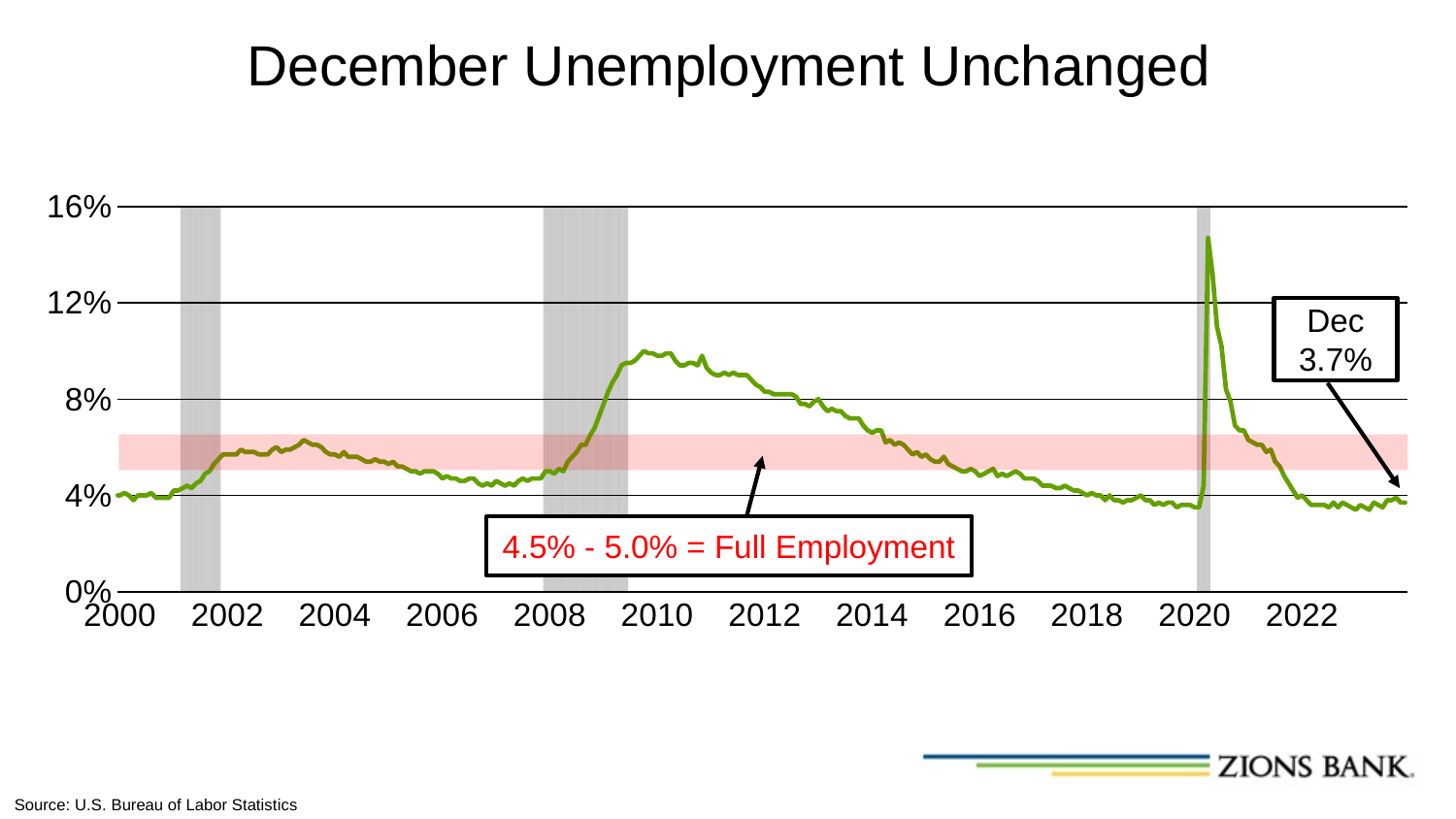
In which year does the unemployment rate reach its highest point on the chart? 2020 Does the unemployment rate rise or fall between 2010 and 2019? fall What range does the chart label as Full Employment? 4.5% - 5.0% What is the December unemployment rate labeled on the chart? 3.7% Does the unemployment rate rise or fall between 2007 and 2010? rise Is the peak unemployment rate in 2020 greater or less than 12%? greater Is the unemployment rate around 2003 greater or less than 8%? less Is the December value of 3.7% greater or less than 4%? less What kind of chart is shown on the slide? line chart Which peak is higher: the one around 2010 or the one in 2020? 2020